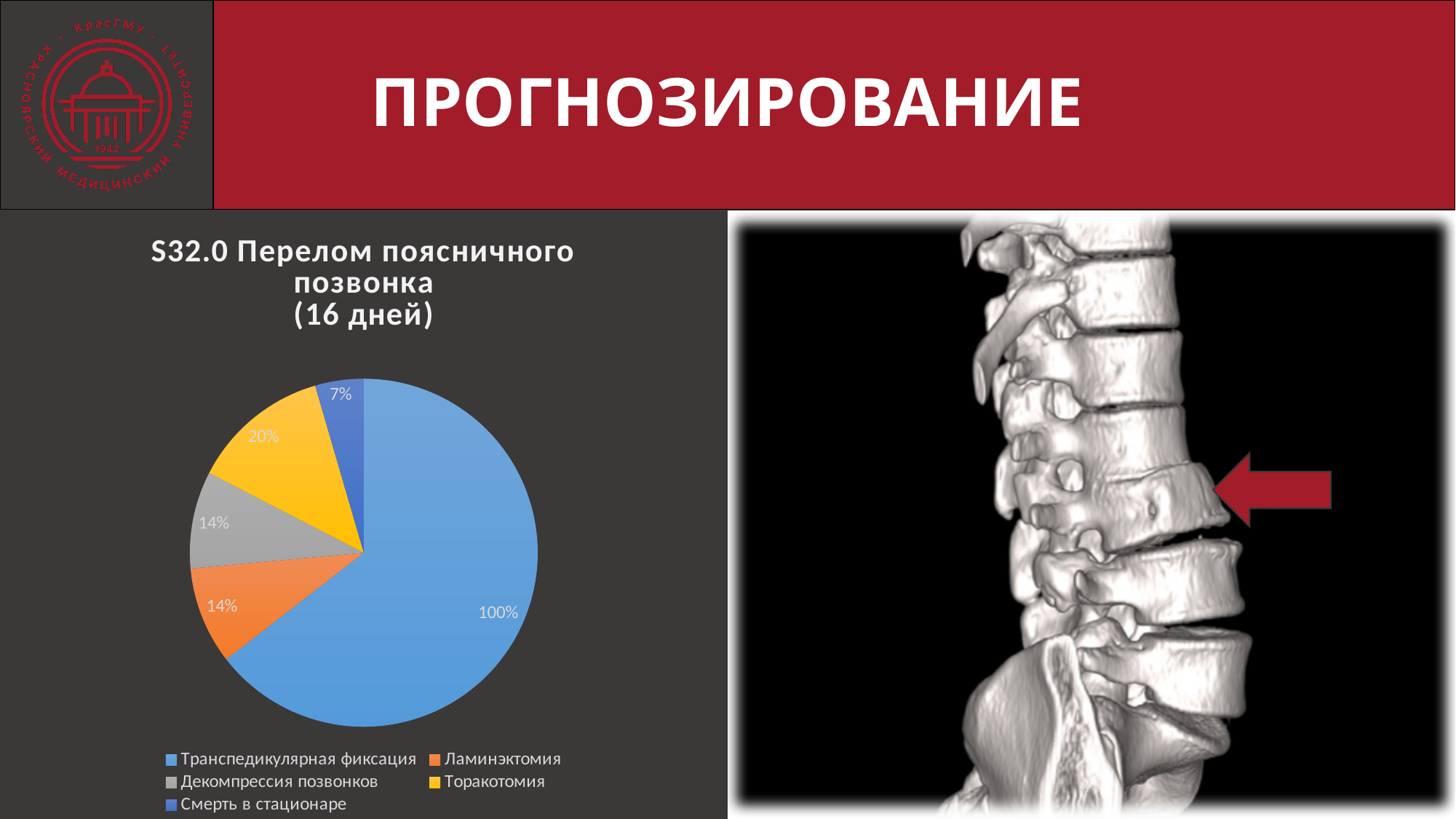
What is the title of the chart? S32.0 Перелом поясничного позвонка (16 дней) Which category has the largest slice in the pie chart? Транспедикулярная фиксация Which category has the smallest slice in the pie chart? Смерть в стационаре What value is labelled on the slice for Ламинэктомия? 14% What kind of chart is shown on the slide? pie chart What value is labelled on the slice for Декомпрессия позвонков? 14% What value is labelled on the slice for Смерть в стационаре? 7% What value is labelled on the slice for Транспедикулярная фиксация? 100% How many categories does the legend of the pie chart list? 5 Which is larger, the value for Торакотомия or the value for Ламинэктомия? Торакотомия What value is labelled on the slice for Торакотомия? 20% What is the difference between the labelled values for Торакотомия and Смерть в стационаре? 13%